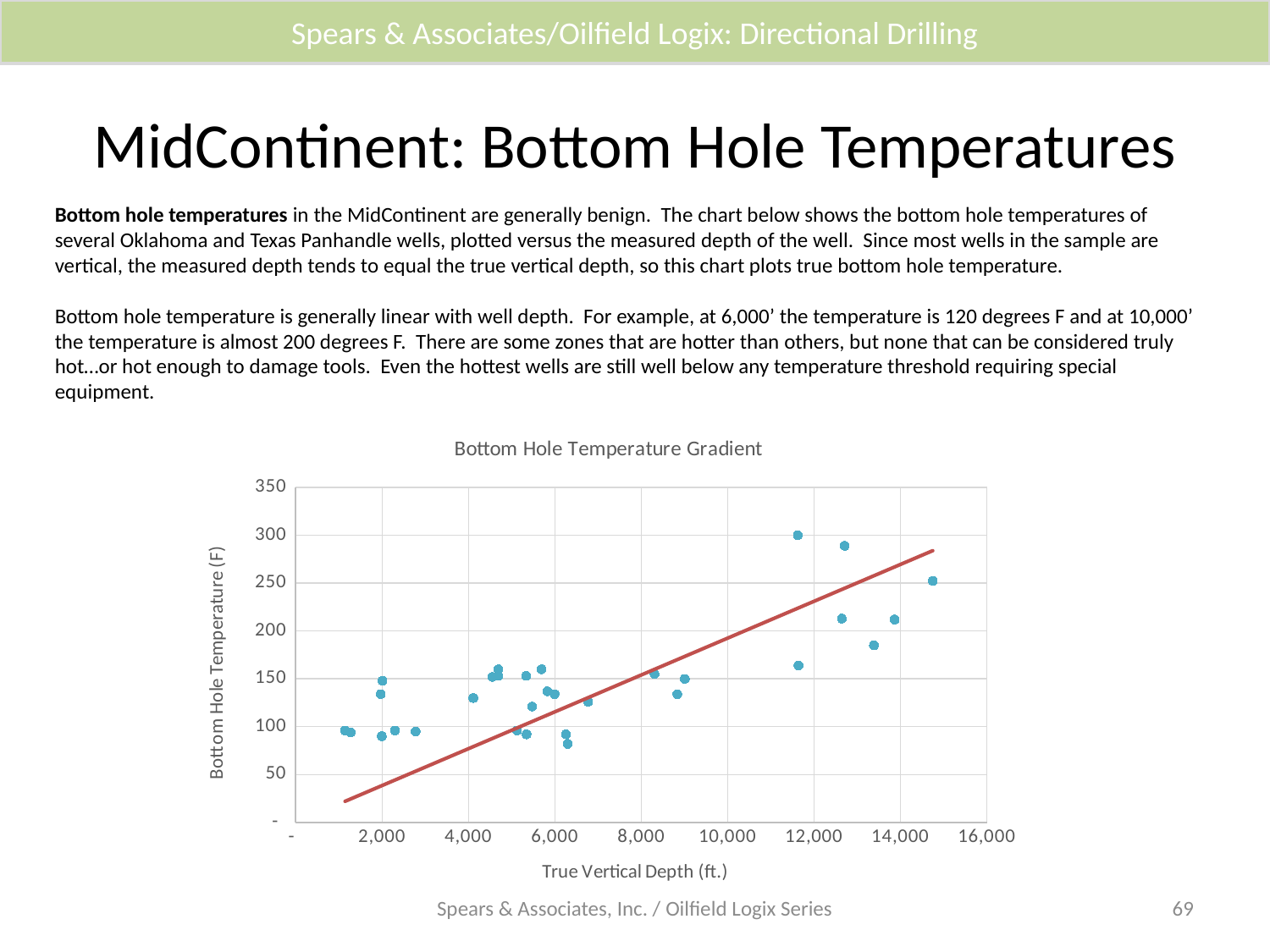
What is the label on the y axis of the chart? Bottom Hole Temperature (F) Are all plotted bottom hole temperatures less than 350? Yes Is the lowest plotted bottom hole temperature greater or less than 100? less What is the title of the chart? Bottom Hole Temperature Gradient Is the highest plotted bottom hole temperature greater or less than 250? greater Do bottom hole temperatures generally rise or fall as true vertical depth increases along the x axis? Rise What kind of chart is shown on the slide? Scatter chart